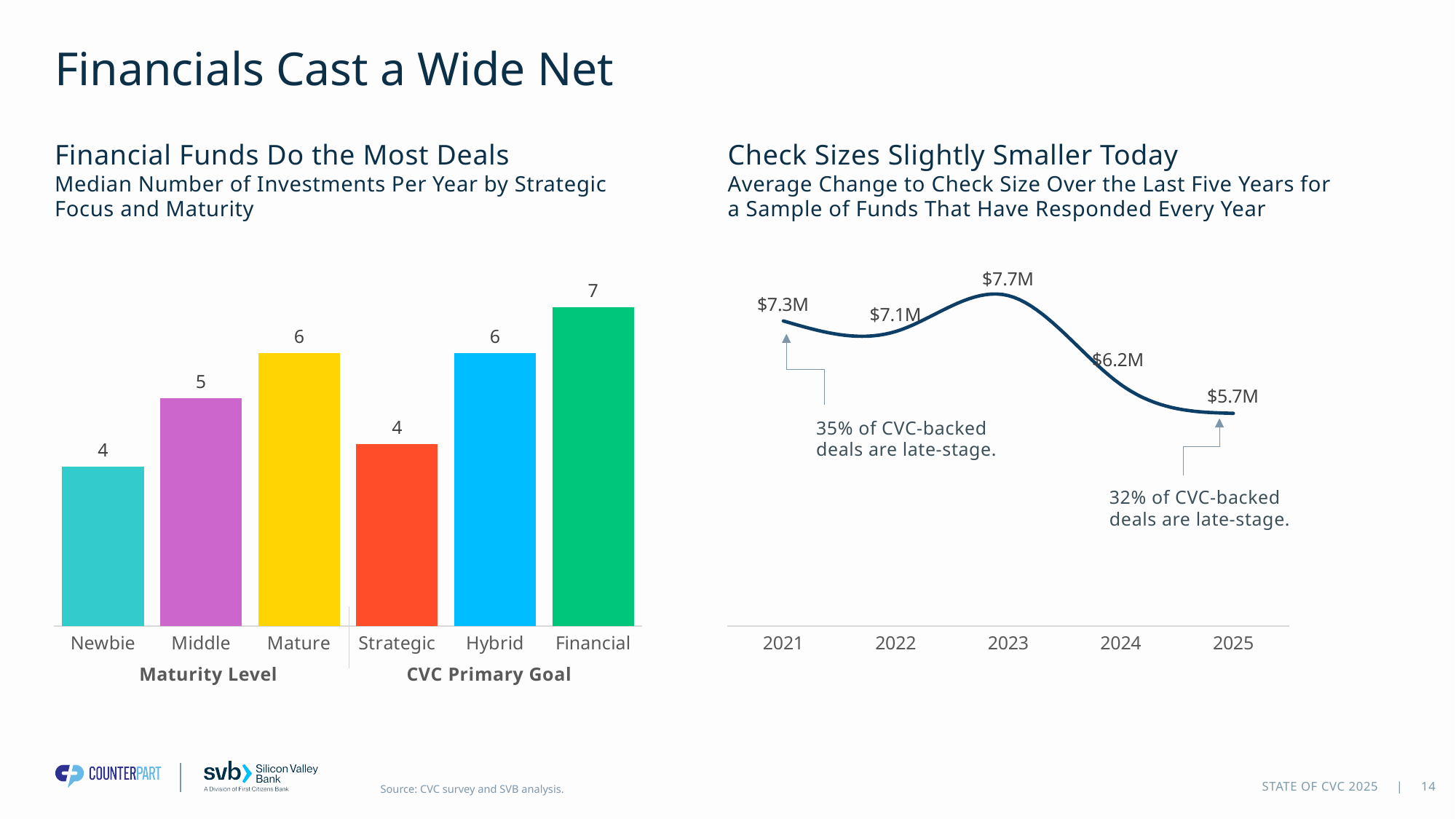
In the 'Financial Funds Do the Most Deals' chart, which is larger, the value for Hybrid or the value for Strategic? Hybrid How many categories are shown in the 'Financial Funds Do the Most Deals' chart? 6 In the 'Check Sizes Slightly Smaller Today' chart, which year has the lowest value? 2025 In the 'Financial Funds Do the Most Deals' chart, what is the difference between the values for Mature and Newbie? 2 In the 'Financial Funds Do the Most Deals' chart, what is the median number of investments per year for Financial funds? 7 In the 'Check Sizes Slightly Smaller Today' chart, what is the difference between the values for 2021 and 2025? $1.6M What kind of chart is 'Financial Funds Do the Most Deals'? Bar chart In the 'Financial Funds Do the Most Deals' chart, which category has the highest value? Financial In the 'Check Sizes Slightly Smaller Today' chart, what is the value for 2023? $7.7M In the 'Check Sizes Slightly Smaller Today' chart, do the values rise or fall from 2023 to 2025? Fall In the 'Financial Funds Do the Most Deals' chart, what is the value for Newbie? 4 What kind of chart is 'Check Sizes Slightly Smaller Today'? Line chart